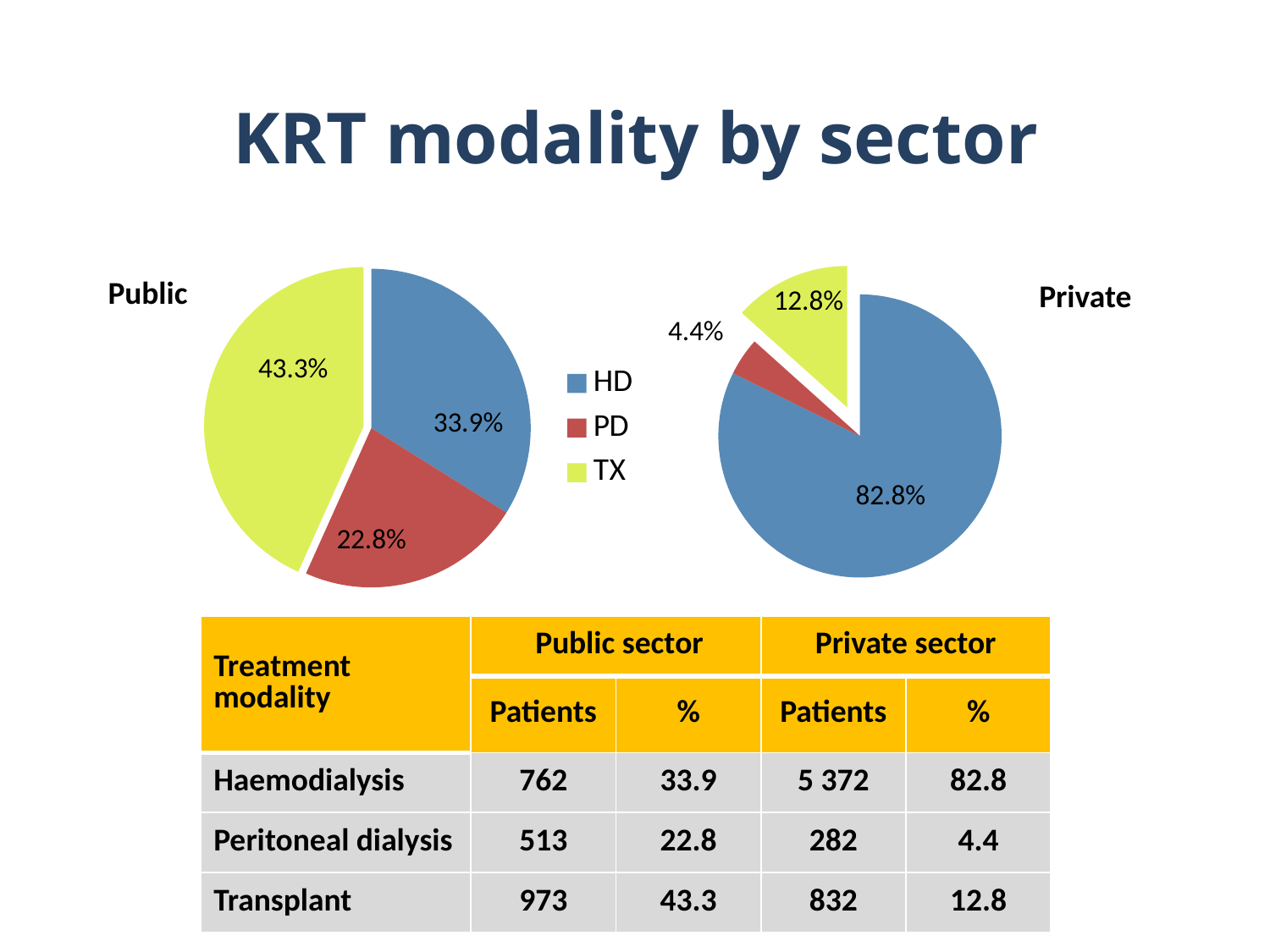
What kind of chart is the Public chart? Pie chart In the Private pie chart, what share does HD have? 82.8% In the Public pie chart, which modality has the smallest share? PD In the Public pie chart, what share does TX have? 43.3% In the Public pie chart, which modality has the largest share? TX How many slices does the Private pie chart have? 3 How many entries does the legend list? 3 In the Private pie chart, what share does PD have? 4.4% In the Public pie chart, which is larger, the HD share or the PD share? HD In the Private pie chart, what is the difference between the HD share and the TX share? 70 percentage points In the Public pie chart, what share does PD have? 22.8% In the Private pie chart, which modality has the smallest share? PD